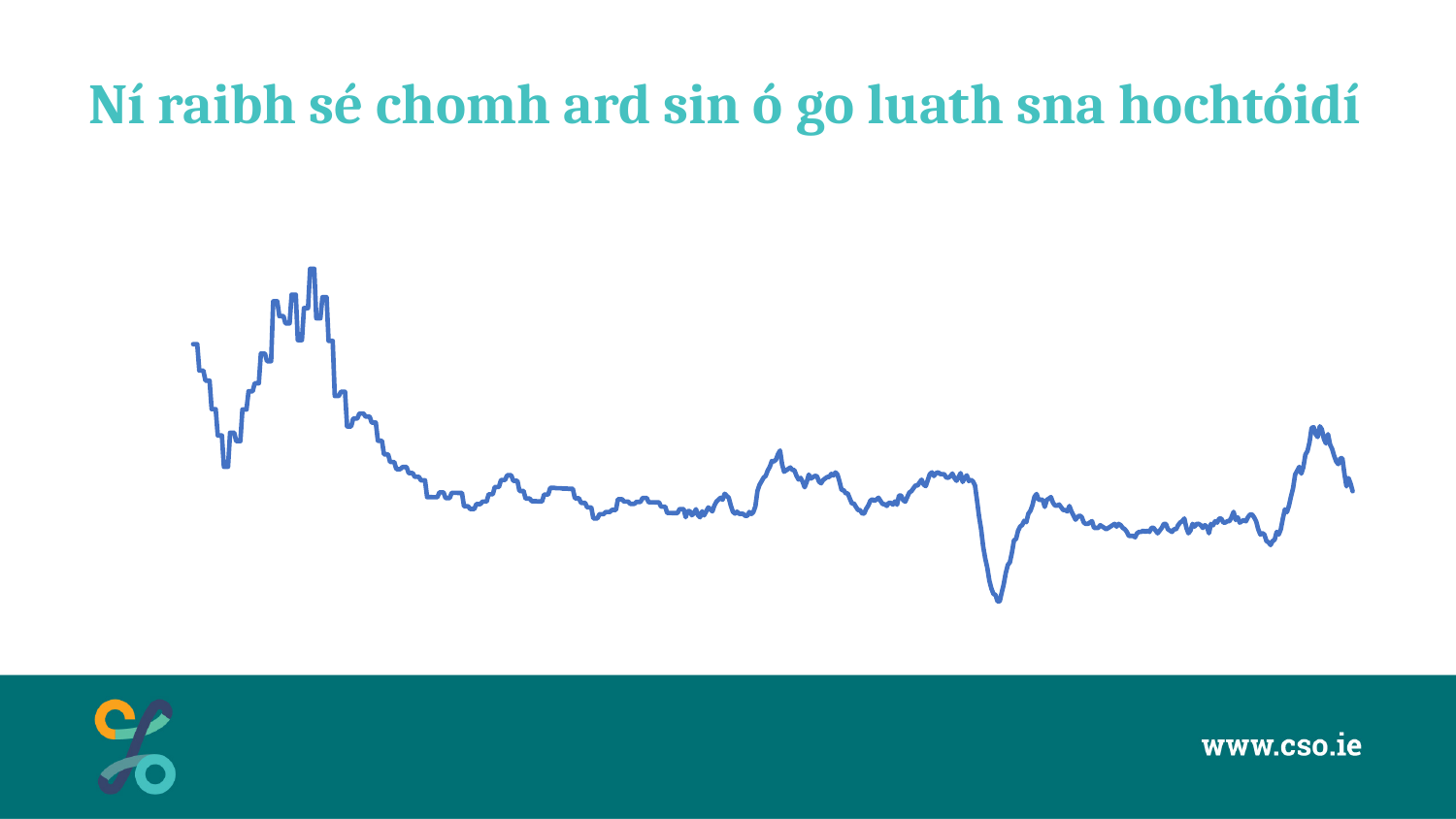
What is the title of the slide above the chart? Ní raibh sé chomh ard sin ó go luath sna hochtóidí Does the line reach its highest point near the left end or near the right end of the chart? near the left end Is the value at the right end of the line higher or lower than the value at the left end? lower What colour is the line on the chart? blue Is the lowest point of the line in the left half or the right half of the chart? right half Does the line rise or fall in the final stretch just before its right end? fall Does the line generally rise or fall from its early peak towards the middle of the chart? fall What kind of chart is shown on the slide? line chart How many lines are plotted on the chart? 1